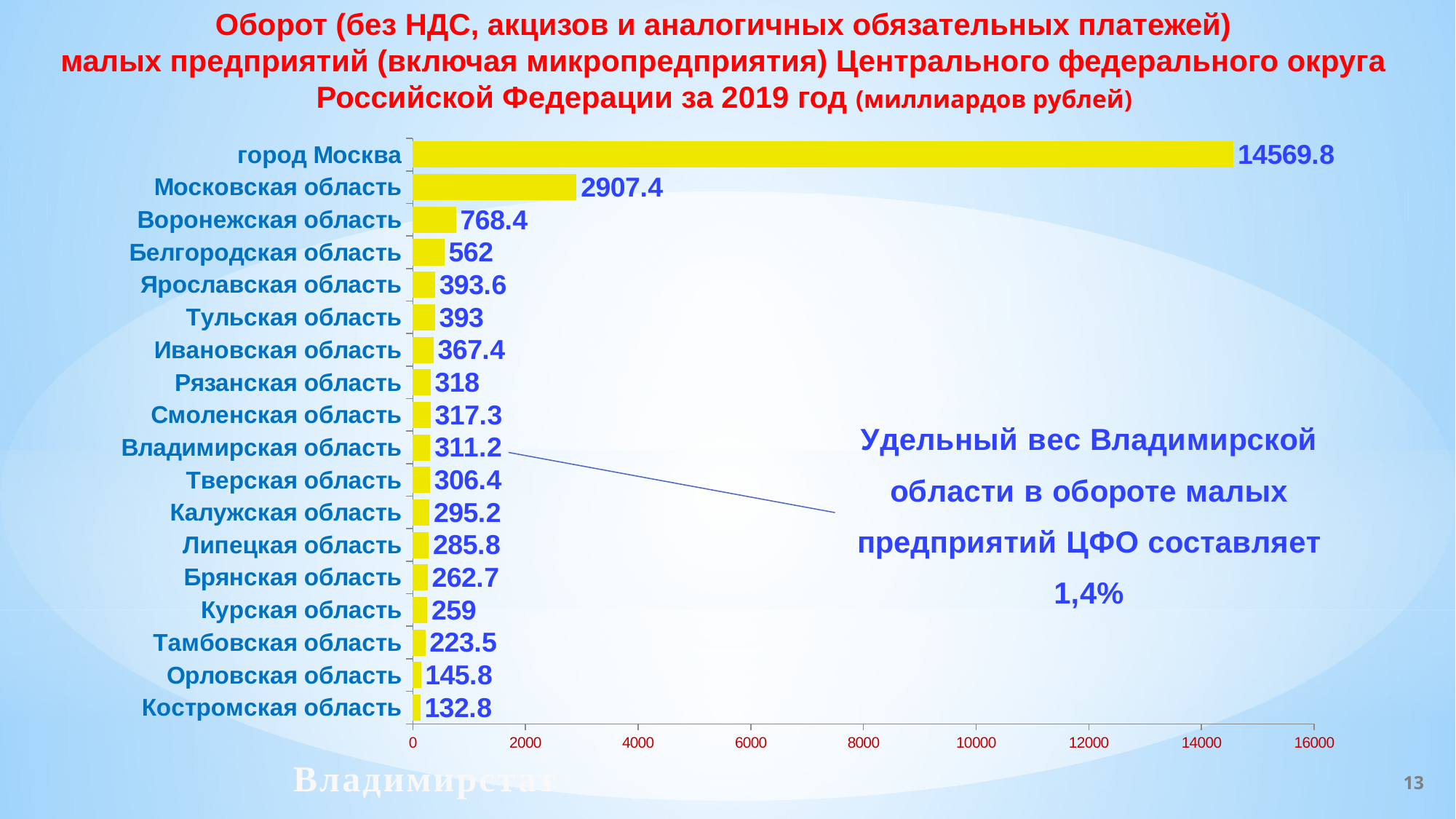
What is the value for Владимирская область? 311.2 What is the difference between the values for Воронежская область and Белгородская область? 206.4 Which is larger, the value for Московская область or Воронежская область? Московская область How many regions are shown in the chart? 18 What kind of chart is shown on the slide? bar chart What is the value for Костромская область? 132.8 What is the difference between the values for город Москва and Московская область? 11662.4 Which region has the highest value? город Москва What is the value for Белгородская область? 562 What is the value for город Москва? 14569.8 Is the value for Московская область greater or less than 2000? greater Which region has the lowest value? Костромская область